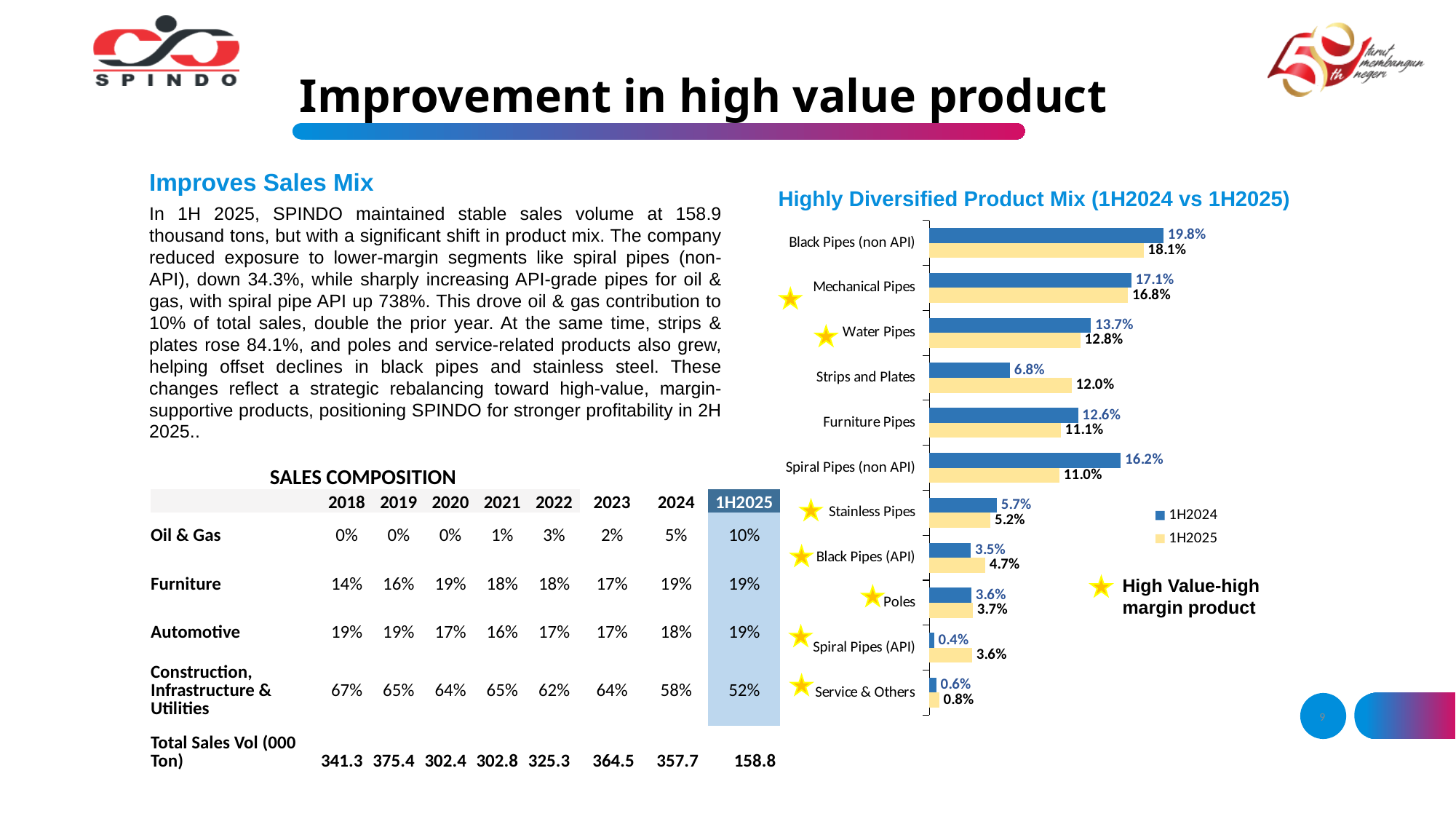
What is the difference between the 1H2024 and 1H2025 values for Spiral Pipes (non API) in the product mix chart? 5.2% Which category has the highest 1H2025 value in the product mix chart? Black Pipes (non API) What type of chart is shown under the title "Highly Diversified Product Mix (1H2024 vs 1H2025)"? Bar chart What is the 1H2024 value for Black Pipes (non API) in the product mix chart? 19.8% Which category has the lowest 1H2024 value in the product mix chart? Spiral Pipes (API) In the product mix chart, which is larger for Water Pipes: the 1H2024 value or the 1H2025 value? 1H2024 What colour are the 1H2025 bars in the product mix chart? Light yellow In the product mix chart, is the 1H2025 value for Strips and Plates larger or smaller than its 1H2024 value? Larger What is the 1H2025 value for Spiral Pipes (API) in the product mix chart? 3.6% How many series does the legend of the product mix chart list? 2 How many product categories are plotted in the product mix chart? 11 What is the 1H2025 value for Strips and Plates in the product mix chart? 12.0%